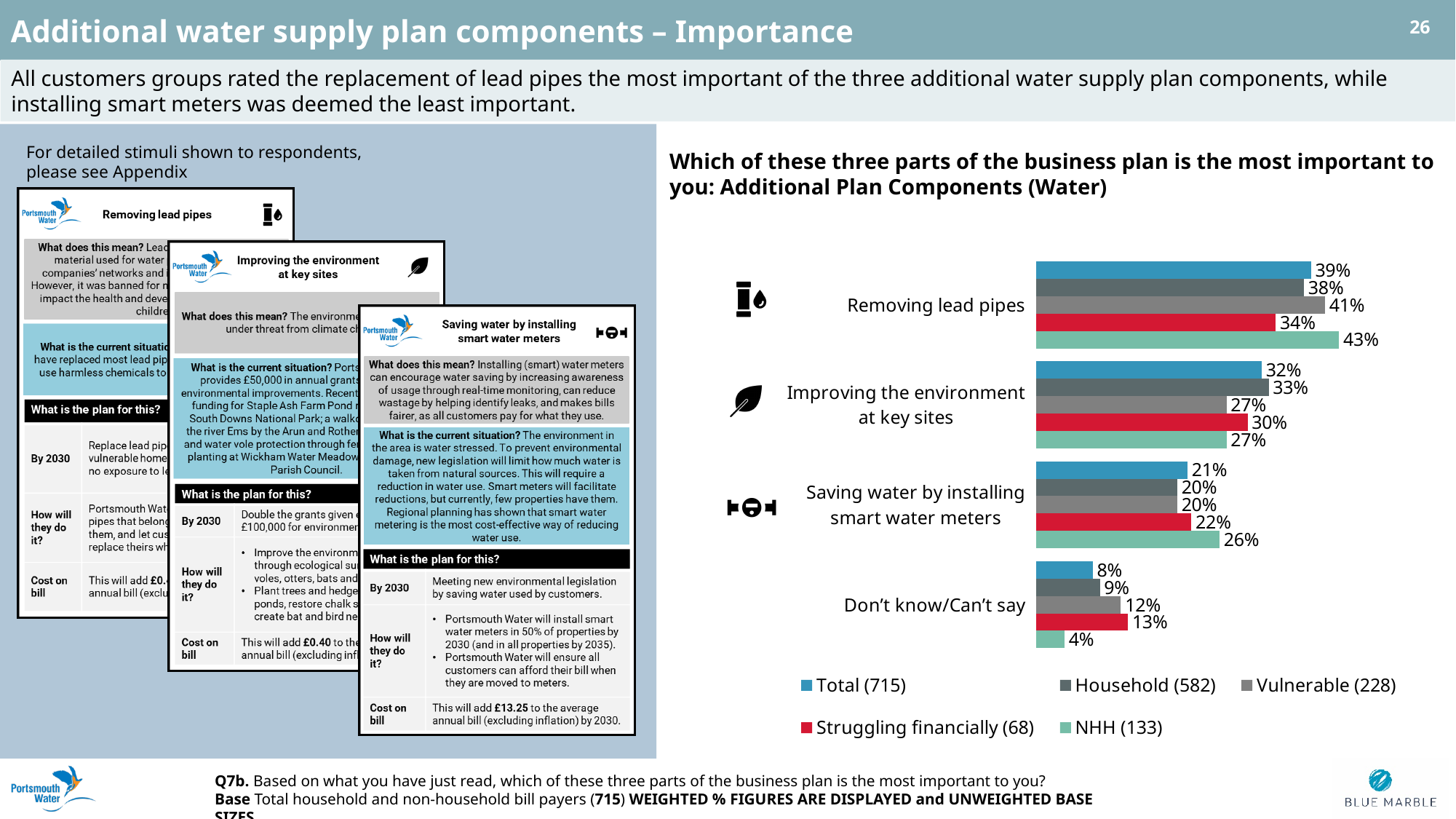
Which customer group has the highest value for Removing lead pipes? NHH (133) How many categories are shown on the chart? 4 For Improving the environment at key sites, which is larger: the Household (582) value or the Vulnerable (228) value? Household (582) How many series does the legend list? 5 What is the value for Struggling financially (68) for Don't know/Can't say? 13% What percentage of the Total (715) group rated Removing lead pipes as most important? 39% Which series is shown in red on the chart? Struggling financially (68) What is the value for NHH (133) for Saving water by installing smart water meters? 26% What is the difference between the Vulnerable (228) and Struggling financially (68) values for Removing lead pipes? 7% What kind of chart is shown on the slide? Bar chart What is the difference between the Total (715) values for Removing lead pipes and Saving water by installing smart water meters? 18% Which customer group has the lowest value for Don't know/Can't say? NHH (133)